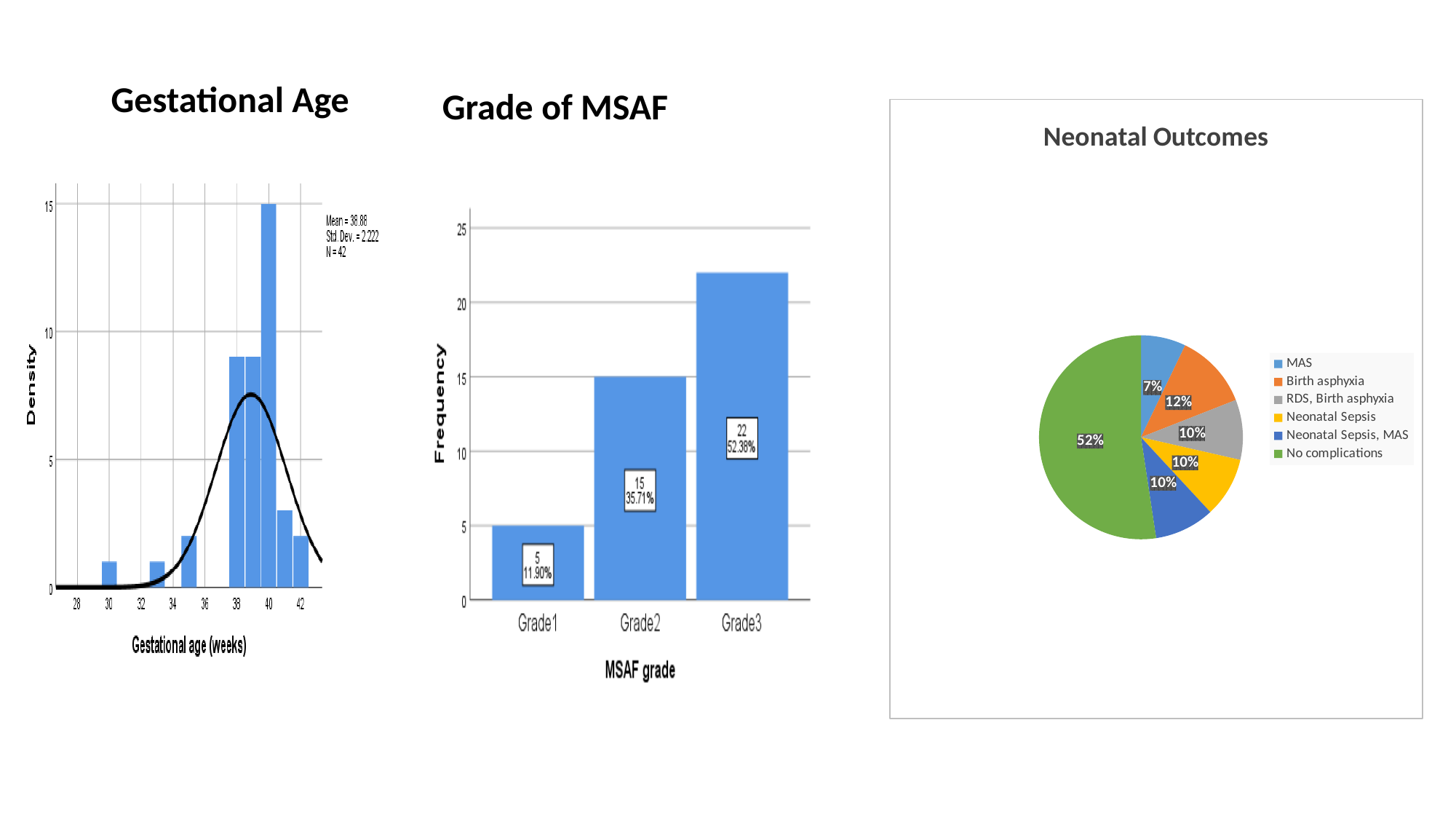
In the Neonatal Outcomes chart, what percentage is shown for Birth asphyxia? 12% In the Neonatal Outcomes chart, how many entries does the legend list? 6 In the Grade of MSAF chart, which grade has the lowest frequency? Grade1 In the Grade of MSAF chart, what is the frequency for Grade3? 22 In the Gestational Age chart, what is the mean gestational age shown in the annotation? 38.88 In the Grade of MSAF chart, what is the difference in frequency between Grade3 and Grade1? 17 In the Neonatal Outcomes chart, which outcome has the smallest slice? MAS In the Grade of MSAF chart, how many grade categories are shown on the x axis? 3 In the Grade of MSAF chart, what percentage is shown for Grade2? 35.71% What kind of chart is the Neonatal Outcomes chart? pie chart In the Grade of MSAF chart, do the frequencies rise or fall from Grade1 to Grade3? rise In the Neonatal Outcomes chart, what share of the pie is No complications? 52%